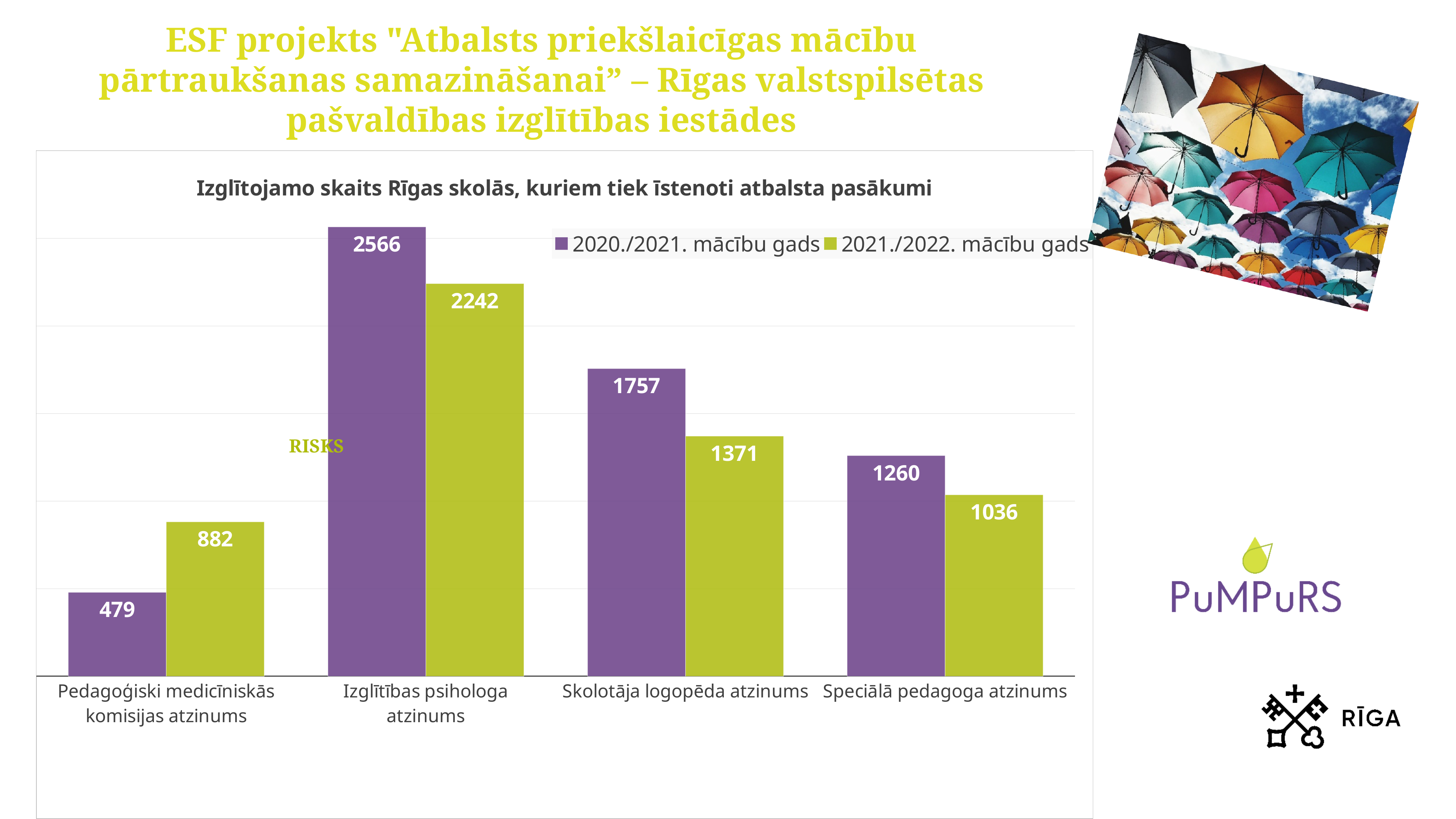
What is the value for Izglītības psihologa atzinums in the 2020./2021. mācību gads series? 2566 What is the value for Pedagoģiski medicīniskās komisijas atzinums in the 2021./2022. mācību gads series? 882 What kind of chart is shown on the slide? Bar chart How many series does the chart legend list? 2 What is the difference between the 2021./2022. and 2020./2021. values for Pedagoģiski medicīniskās komisijas atzinums? 403 What is the value for Skolotāja logopēda atzinums in the 2021./2022. mācību gads series? 1371 Which category has the highest value in the 2020./2021. mācību gads series? Izglītības psihologa atzinums For Skolotāja logopēda atzinums, which series has the larger value: 2020./2021. mācību gads or 2021./2022. mācību gads? 2020./2021. mācību gads How many categories are shown on the x axis of the chart? 4 What is the value for Speciālā pedagoga atzinums in the 2020./2021. mācību gads series? 1260 What is the difference between the 2020./2021. and 2021./2022. values for Izglītības psihologa atzinums? 324 Which category has the lowest value in the 2021./2022. mācību gads series? Pedagoģiski medicīniskās komisijas atzinums